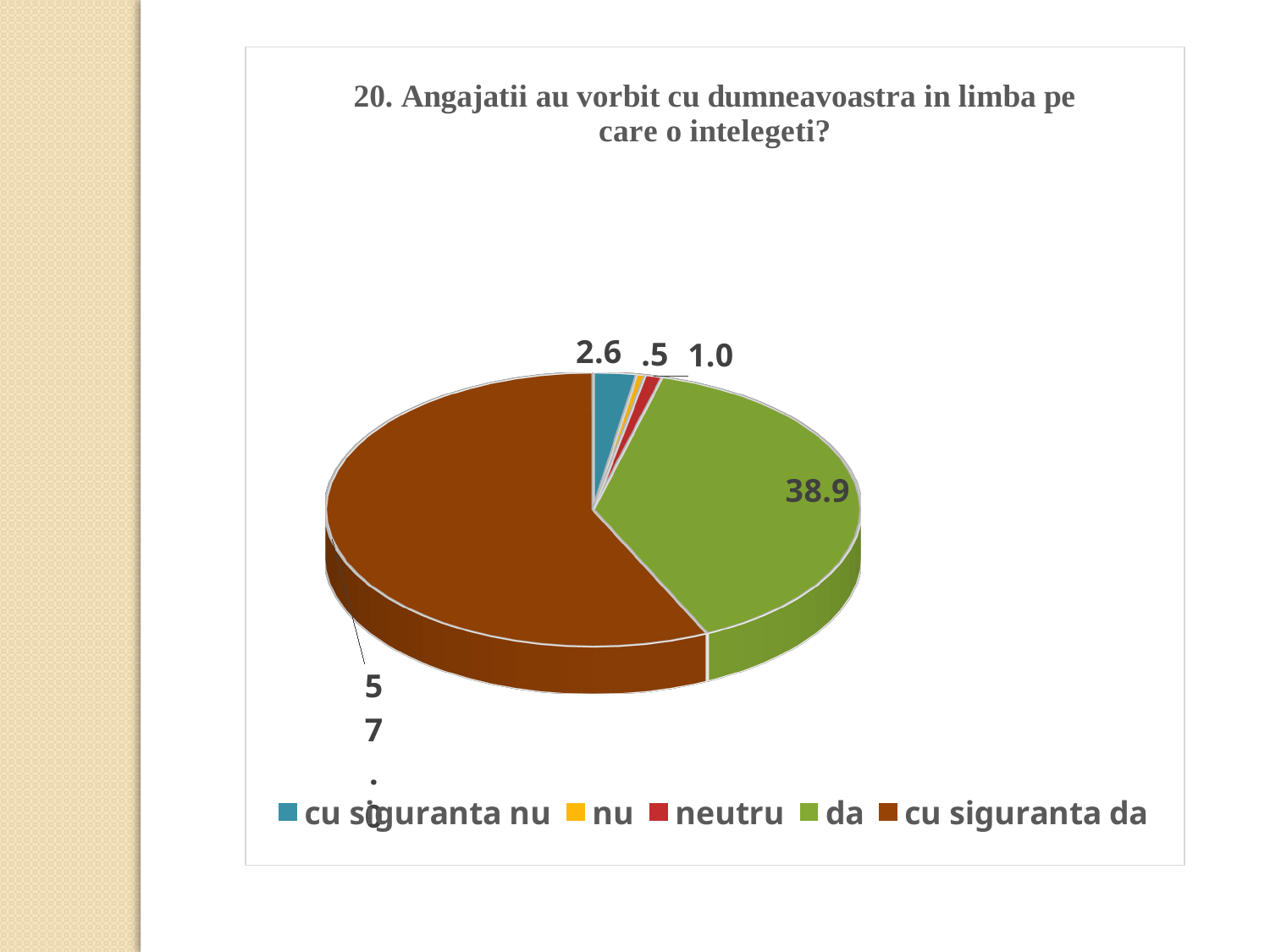
What is the value shown for the "neutru" slice? 1.0 What kind of chart is shown on the slide? Pie chart Which category has the largest slice of the pie? cu siguranta da Which category has the smallest slice of the pie? nu What is the title of the chart? 20. Angajatii au vorbit cu dumneavoastra in limba pe care o intelegeti? What is the value shown for the "da" slice? 38.9 What is the value shown for the "nu" slice? .5 Which is larger, the value for "da" or the value for "cu siguranta nu"? da What is the value shown for the "cu siguranta nu" slice? 2.6 What is the difference between the value for "da" and the value for "cu siguranta nu"? 36.3 What colour is the "da" slice in the pie chart? Green How many categories does the pie chart show? 5